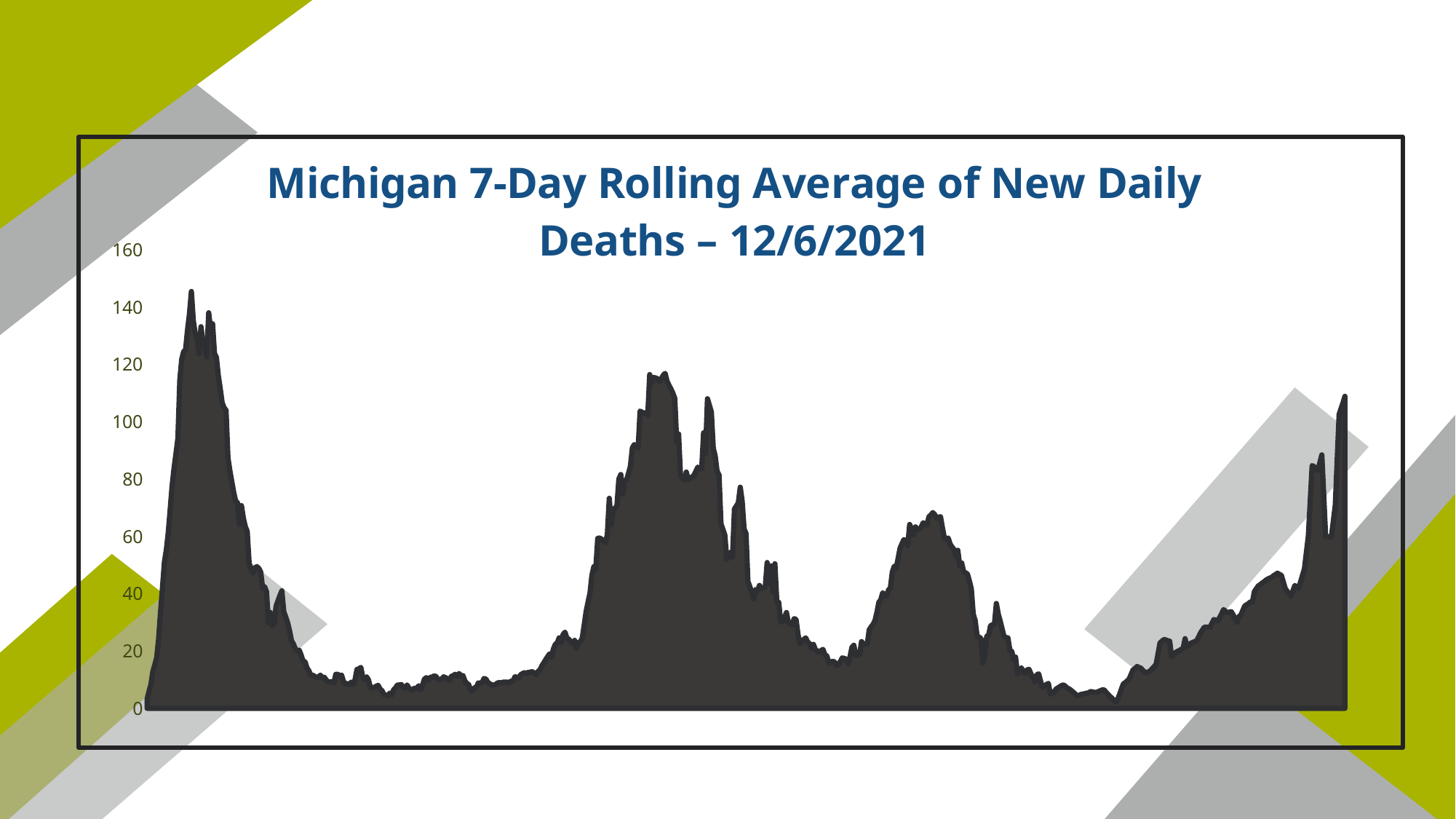
Does the chart have a legend? No Is the peak of the third major wave (the one in the right-centre of the chart) greater or less than 60? greater Is the highest peak of the chart greater or less than 120? greater Is the peak of the second major wave (near the centre of the chart) greater or less than 100? greater What is the title of the chart? Michigan 7-Day Rolling Average of New Daily Deaths – 12/6/2021 What kind of chart is shown on the slide? area chart What is the highest value labelled on the vertical axis? 160 Which is higher: the first peak on the left of the chart or the peak near the centre of the chart? the first peak on the left Does the chart rise or fall over its final stretch at the right-hand side? rise